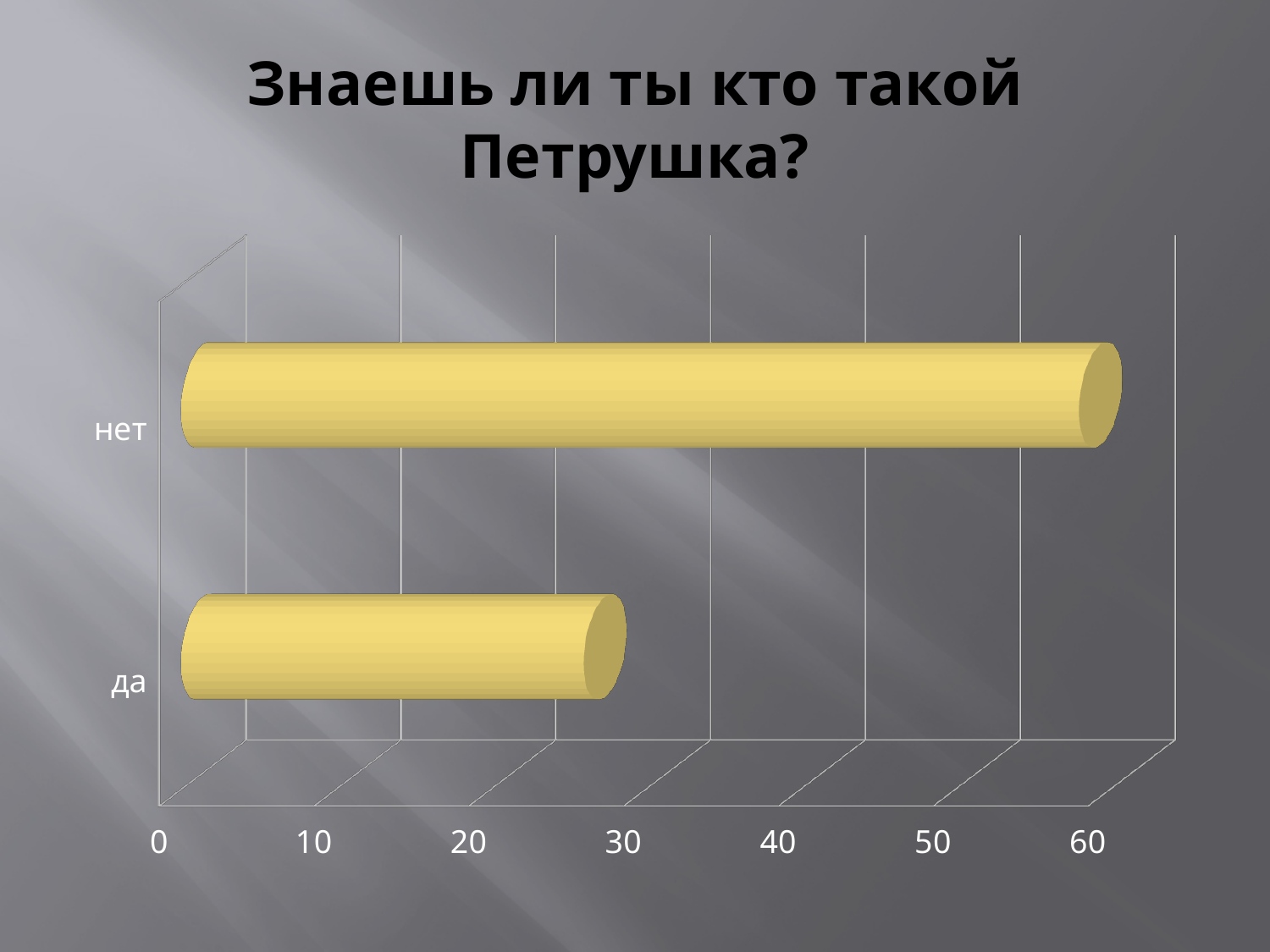
Which category has the highest value? нет Which category has the lowest value? да Which is larger, the value for "нет" or the value for "да"? нет Is the value for "нет" greater or less than 40? greater How many categories are shown in the chart? 2 Is the value for "нет" greater or less than 50? greater What kind of chart is shown on the slide? bar chart Is the value for "да" greater or less than 10? greater What is the highest value shown on the horizontal axis? 60 What is the title of the chart? Знаешь ли ты кто такой Петрушка?